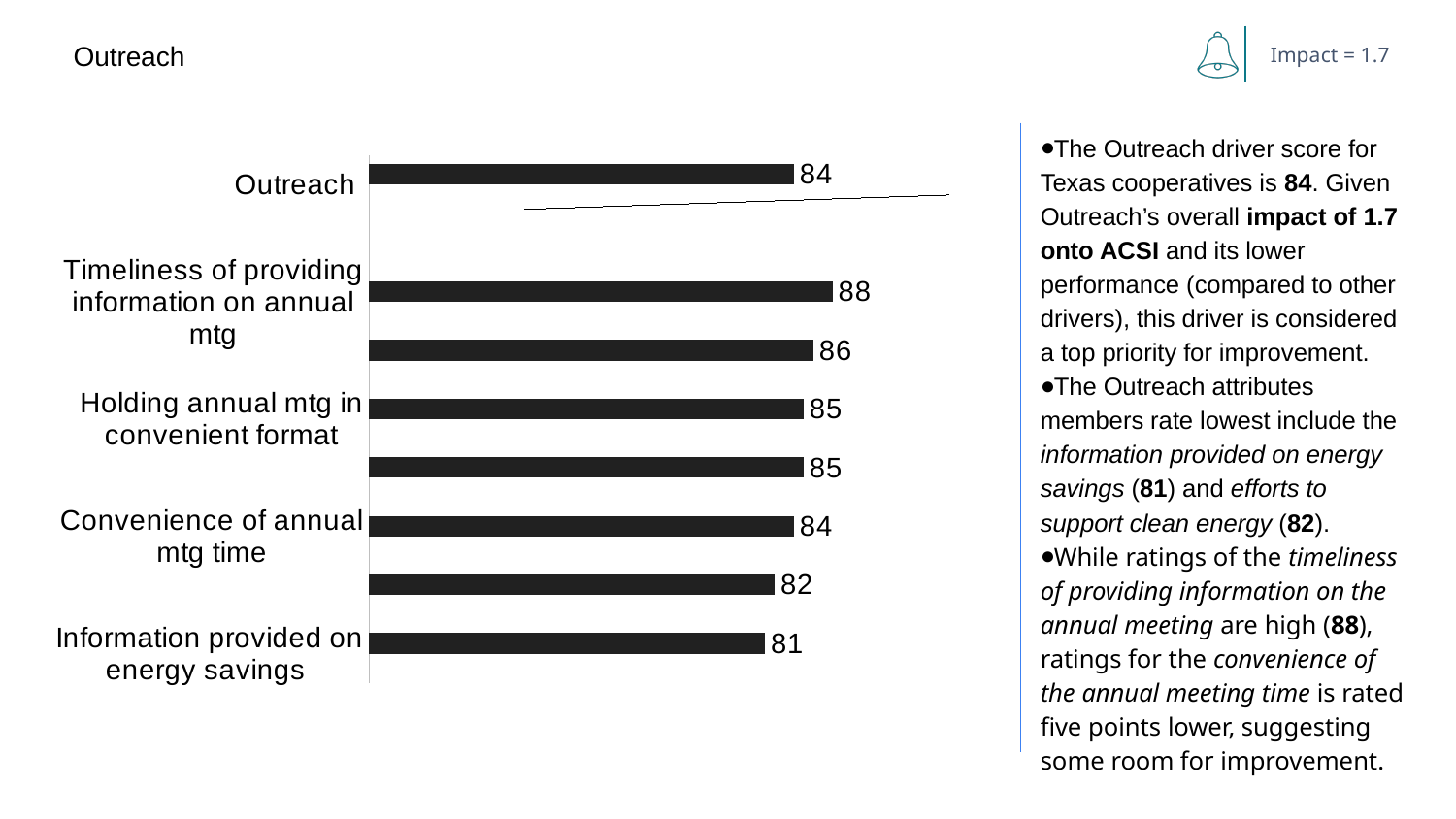
What is the value of the Outreach bar? 84 How many bars are plotted in the chart? 8 Which labeled attribute has the highest value? Timeliness of providing information on annual mtg What type of chart is shown on the slide? bar chart Which is larger, the value for Holding annual mtg in convenient format or the value for Information provided on energy savings? Holding annual mtg in convenient format What is the value for Timeliness of providing information on annual mtg? 88 What is the value for Holding annual mtg in convenient format? 85 What is the difference between the values for Timeliness of providing information on annual mtg and Convenience of annual mtg time? 4 What is the value for Information provided on energy savings? 81 What is the value for Convenience of annual mtg time? 84 What is the title of the slide containing the chart? Outreach Which labeled attribute has the lowest value? Information provided on energy savings